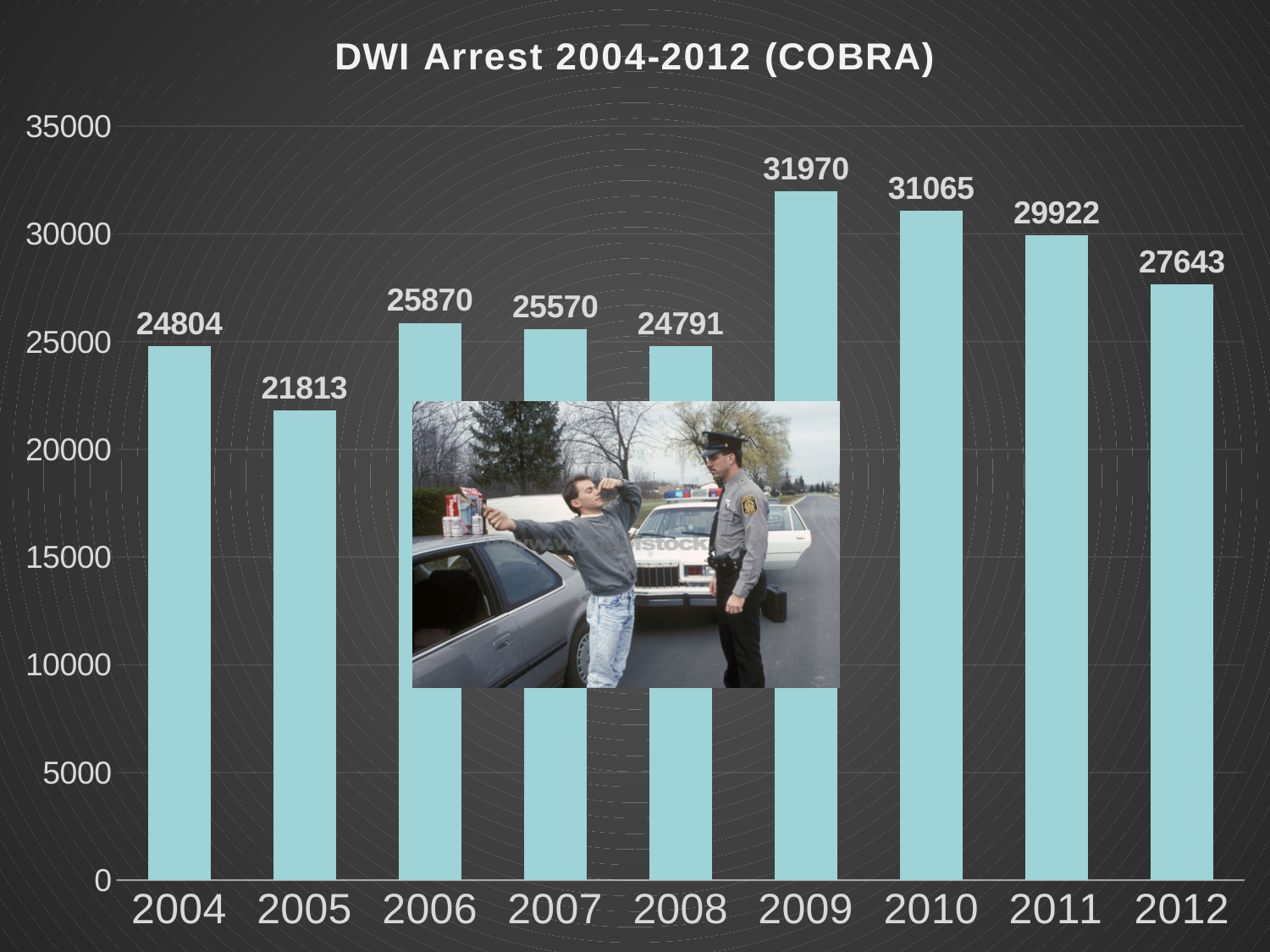
What is the difference between the values for 2004 and 2005? 2991 What is the value for 2009? 31970 What is the value for 2005? 21813 Which is larger, the value for 2006 or the value for 2007? 2006 What is the value for 2012? 27643 What is the difference between the values for 2009 and 2010? 905 Which year has the highest value? 2009 What is the title of the chart? DWI Arrest 2004-2012 (COBRA) What kind of chart is this? bar chart Is the value for 2011 greater or less than 25000? greater Which year has the lowest value? 2005 How many years are shown on the x axis? 9